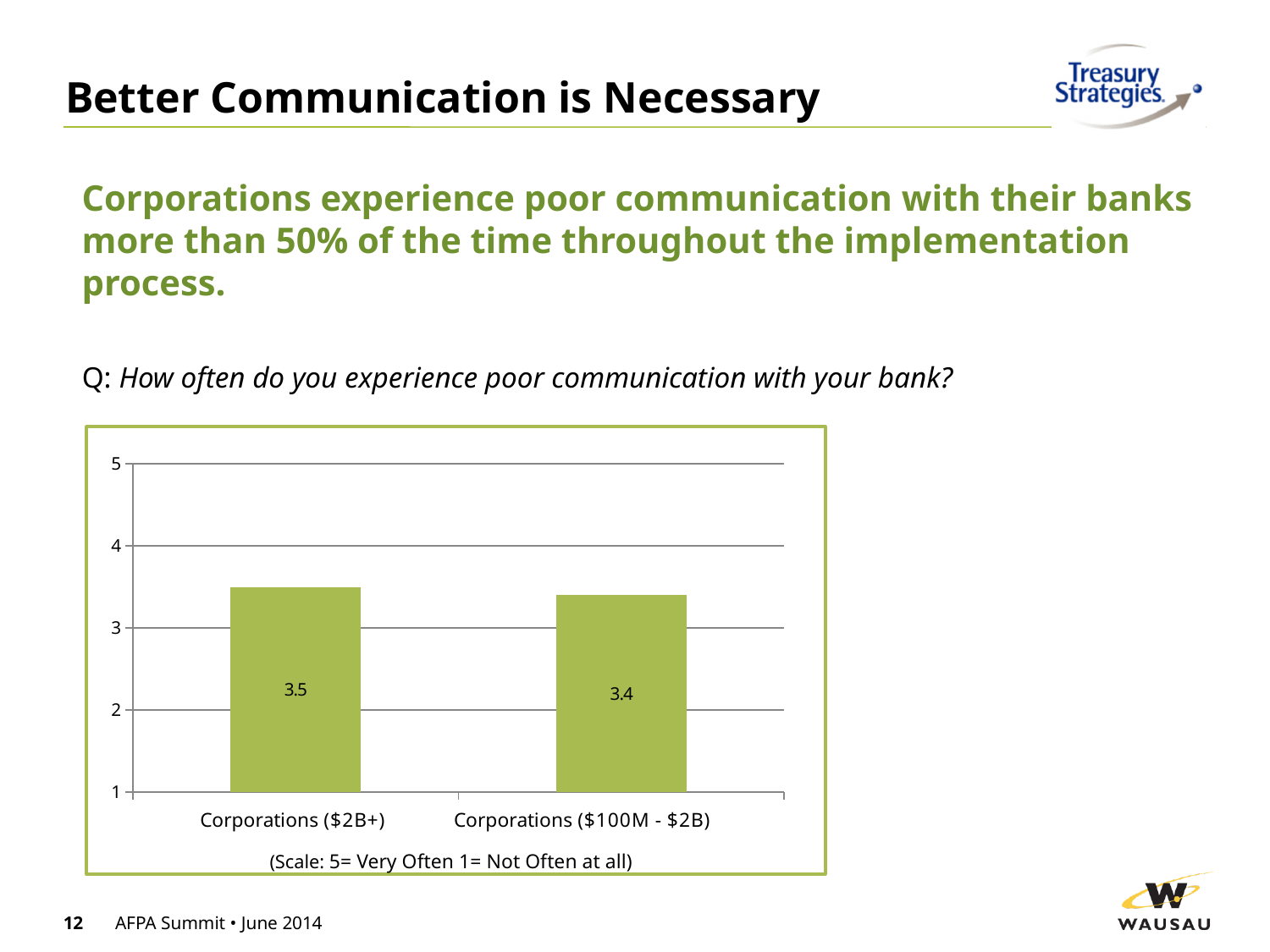
What is the value for Corporations ($100M - $2B)? 3.4 Which category has the lowest value? Corporations ($100M - $2B) How many categories are shown in the chart? 2 Is the value for Corporations ($2B+) greater or less than 3? greater What is the difference between the values for Corporations ($2B+) and Corporations ($100M - $2B)? 0.1 Which category has the highest value? Corporations ($2B+) Is the value for Corporations ($100M - $2B) greater or less than 4? less What is the value for Corporations ($2B+)? 3.5 What kind of chart is shown on the slide? bar chart According to the scale note below the chart, what does a value of 5 represent? Very Often What is the maximum value shown on the vertical axis of the chart? 5 Which is larger, the value for Corporations ($2B+) or for Corporations ($100M - $2B)? Corporations ($2B+)